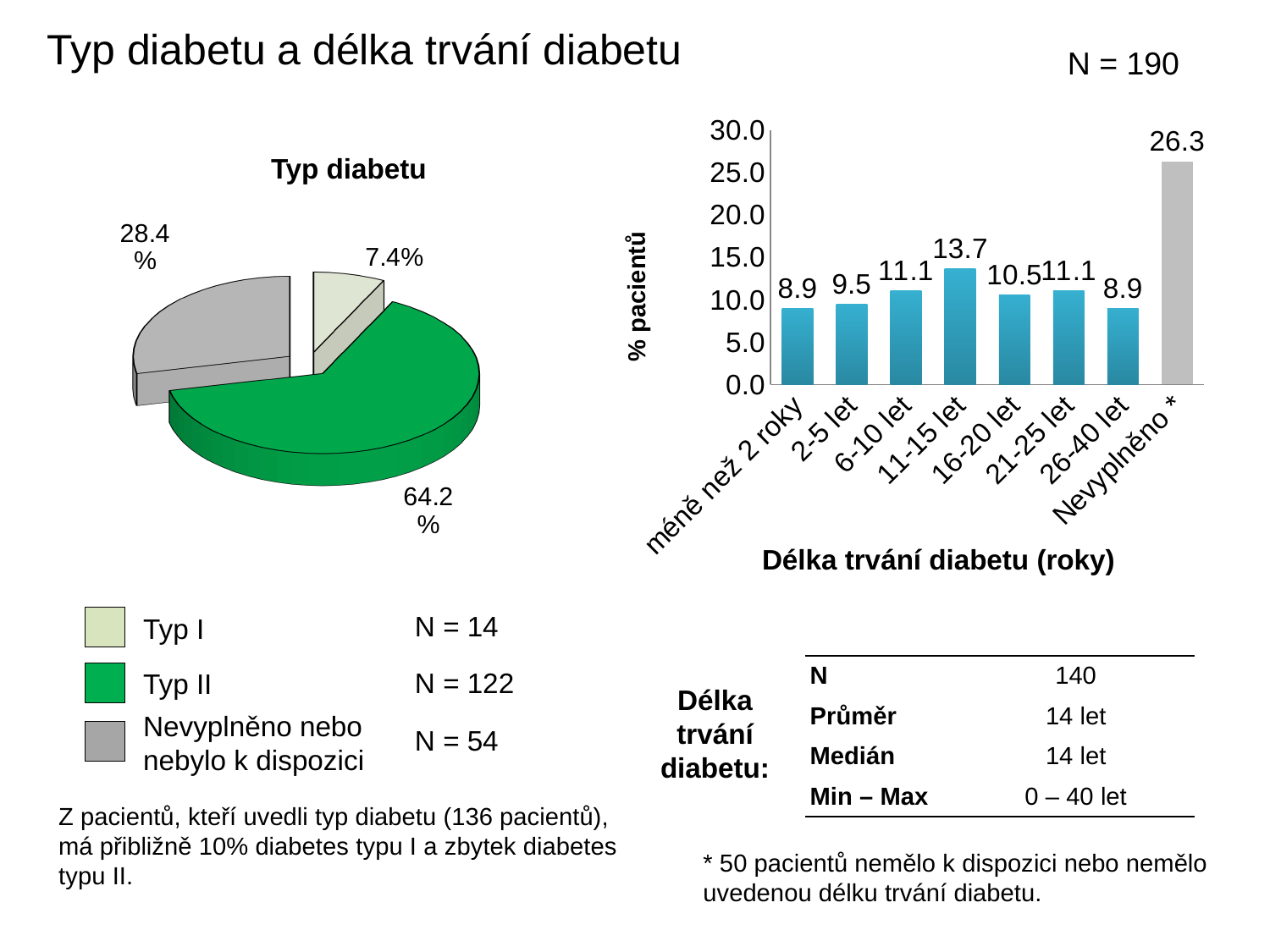
In the bar chart on the right, how many categories are shown on the x axis? 8 In the pie chart 'Typ diabetu', what share is shown for Typ I? 7.4% In the bar chart on the right, which is larger: the value for '16-20 let' or the value for '21-25 let'? 21-25 let What kind of chart is the chart on the right of the slide? bar chart In the pie chart 'Typ diabetu', which category has the smallest slice? Typ I In the bar chart on the right, which category has the highest value? Nevyplněno * In the pie chart 'Typ diabetu', which category has the largest slice? Typ II In the pie chart 'Typ diabetu', how many slices are there? 3 In the bar chart on the right, what is the value for 'Nevyplněno *'? 26.3 In the pie chart 'Typ diabetu', what share is shown for Typ II? 64.2% In the bar chart on the right, what is the difference between the values for '11-15 let' and '2-5 let'? 4.2 In the bar chart on the right, what is the value for '11-15 let'? 13.7